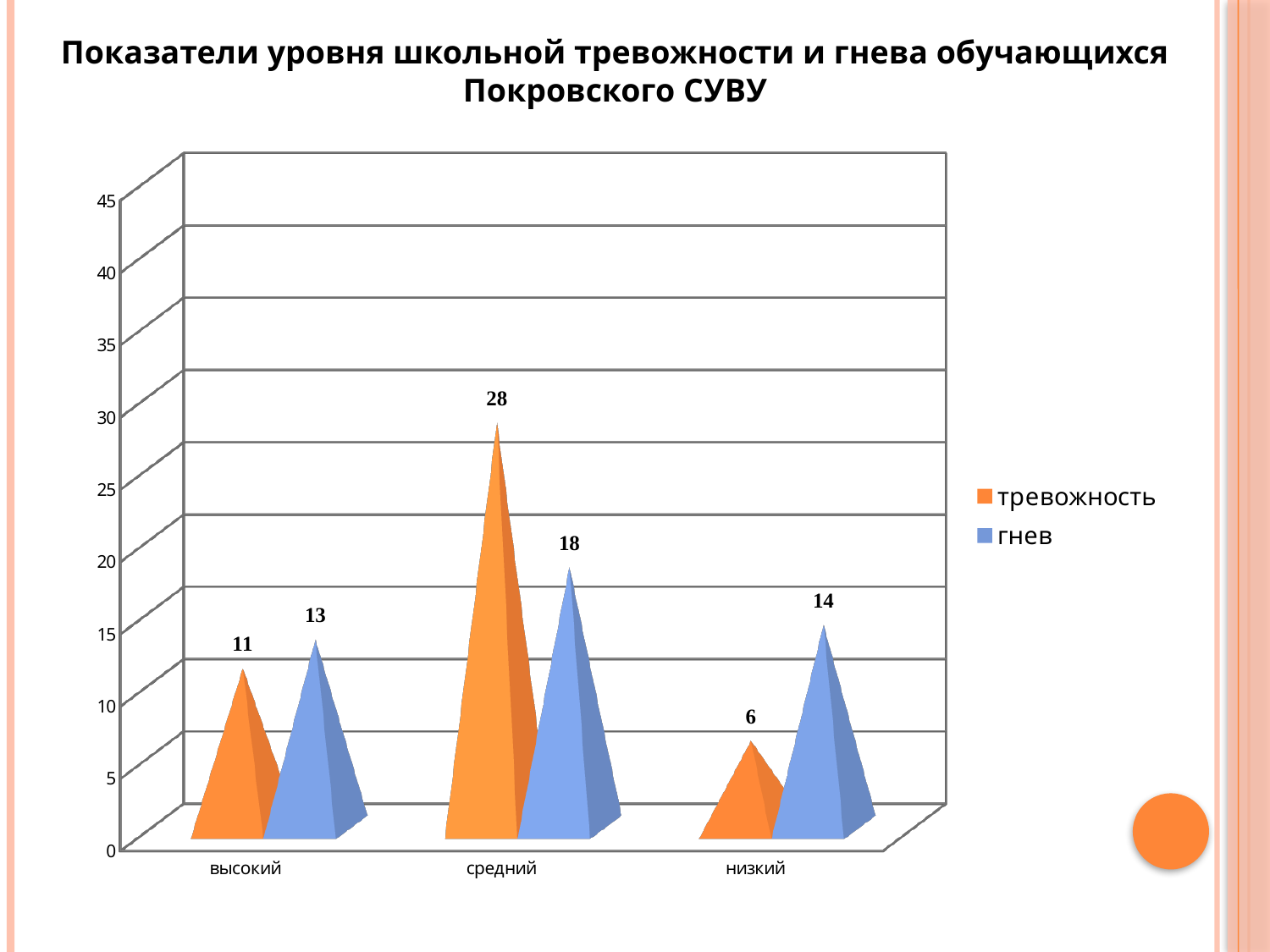
Is the value for гнев in the низкий category greater or less than 10? greater What is the value for тревожность in the средний category? 28 What colour represents the гнев series? blue What is the difference between тревожность and гнев in the средний category? 10 How many series does the legend list? 2 What is the value for тревожность in the низкий category? 6 What is the value for гнев in the высокий category? 13 How many categories are shown on the x axis? 3 Which category has the highest value for гнев? средний What kind of chart is shown on the slide? bar chart Which category has the lowest value for тревожность? низкий Which is larger in the низкий category, тревожность or гнев? гнев